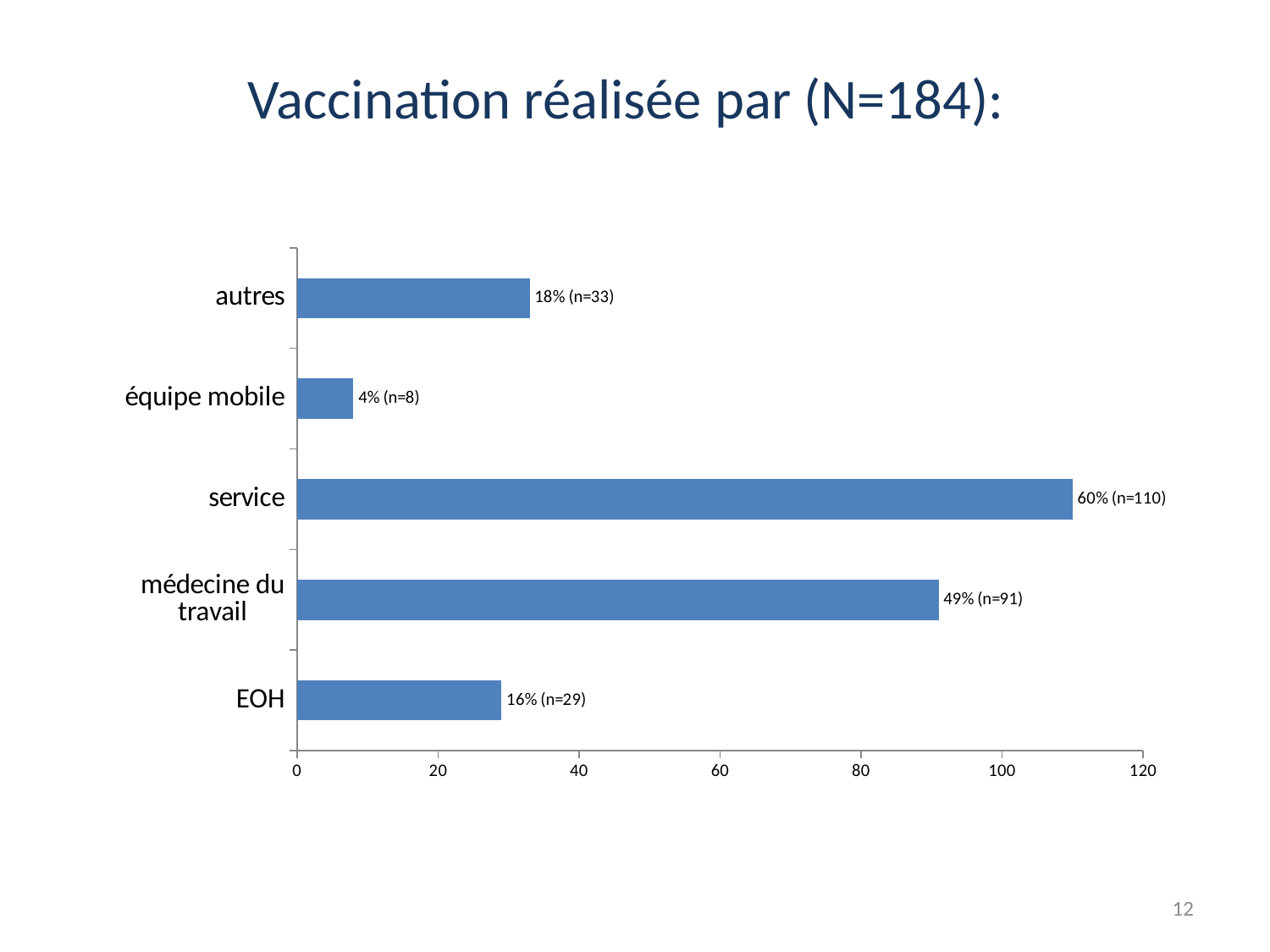
What is the data label shown for the 'médecine du travail' bar? 49% (n=91) Which category has the highest value? service Which category has the lowest value? équipe mobile Which has a larger value, 'autres' or 'EOH'? autres What is the difference in count (n) between 'service' and 'médecine du travail'? 19 How many categories are shown in the chart? 5 Is the value for 'médecine du travail' greater or less than 80? greater What is the data label shown for the 'service' bar? 60% (n=110) What is the title of the chart on the slide? Vaccination réalisée par (N=184): What is the data label shown for the 'équipe mobile' bar? 4% (n=8) What kind of chart is shown on the slide? bar chart What is the data label shown for the 'EOH' bar? 16% (n=29)